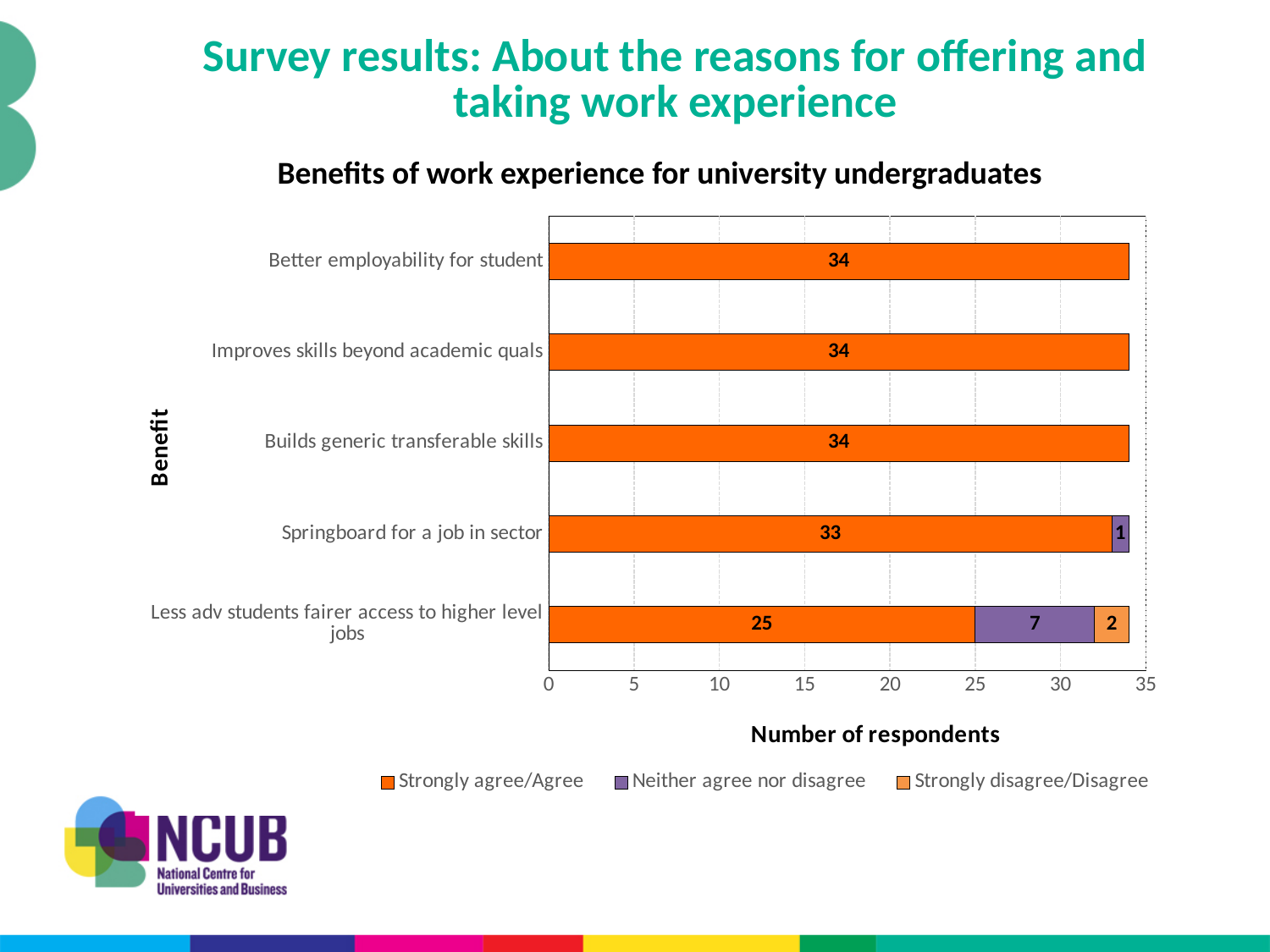
What is the total of the stacked bar for Less adv students fairer access to higher level jobs? 34 What is the Strongly agree/Agree value for Less adv students fairer access to higher level jobs? 25 What is the Strongly agree/Agree value for Better employability for student? 34 How many benefit categories are shown on the chart? 5 Which is larger: the Strongly agree/Agree value for Builds generic transferable skills or for Springboard for a job in sector? Builds generic transferable skills Which benefit has the lowest Strongly agree/Agree value? Less adv students fairer access to higher level jobs What is the Neither agree nor disagree value for Springboard for a job in sector? 1 What is the Strongly disagree/Disagree value for Less adv students fairer access to higher level jobs? 2 What is the Neither agree nor disagree value for Less adv students fairer access to higher level jobs? 7 How many series does the legend list? 3 What kind of chart is shown on the slide? Stacked bar chart What is the difference between the Strongly agree/Agree values for Springboard for a job in sector and Less adv students fairer access to higher level jobs? 8